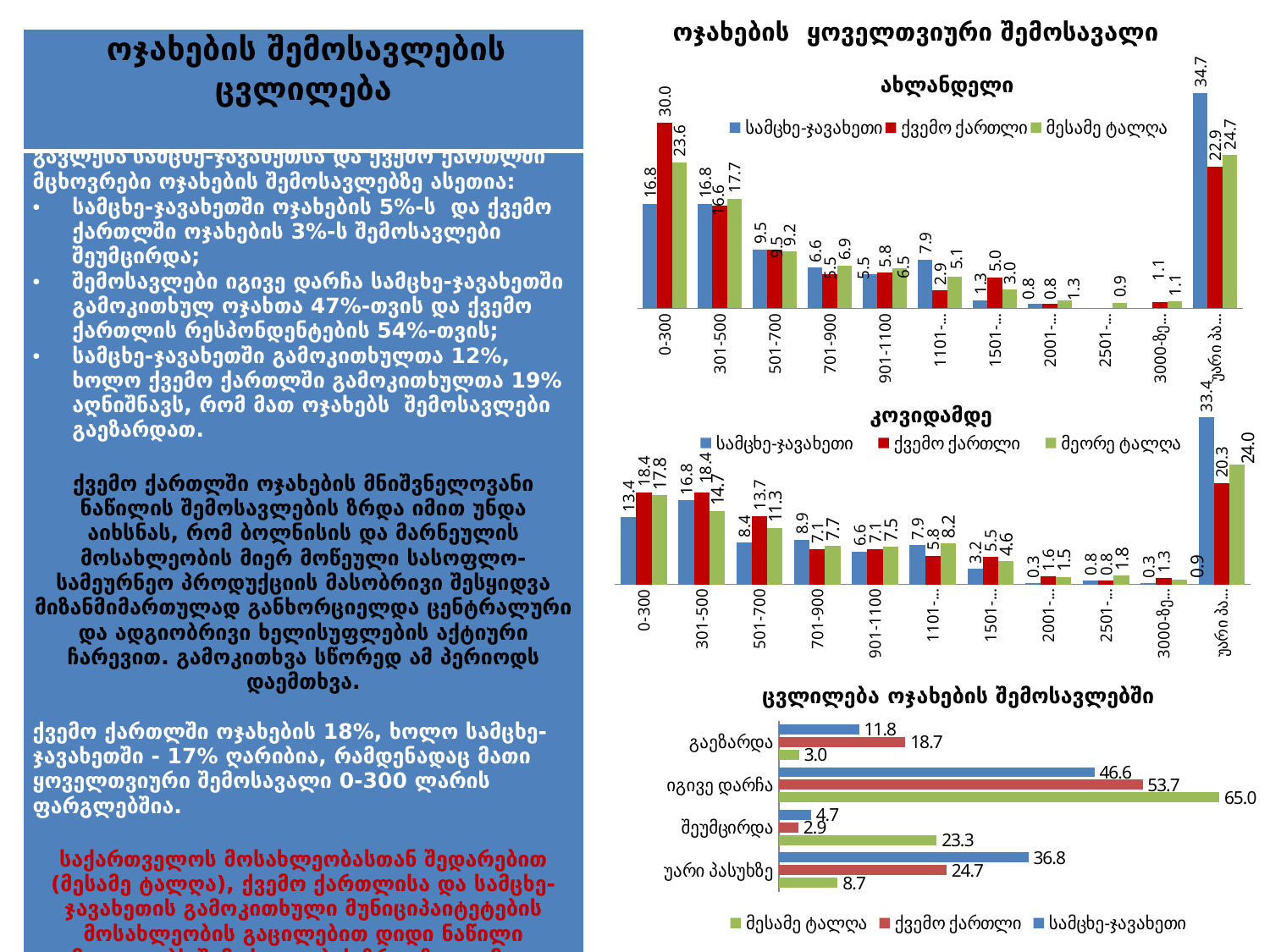
In the bottom chart (ცვლილება ოჯახების შემოსავლებში), what is the value for ქვემო ქართლი in the იგივე დარჩა category? 53.7 What type of chart is the bottom chart (ცვლილება ოჯახების შემოსავლებში)? bar chart In the middle chart (კოვიდამდე), what is the value for სამცხე-ჯავახეთი in the 501-700 category? 8.4 In the middle chart (კოვიდამდე), which is larger in the 0-300 category: ქვემო ქართლი or სამცხე-ჯავახეთი? ქვემო ქართლი In the bottom chart (ცვლილება ოჯახების შემოსავლებში), how many categories are shown? 4 In the middle chart (კოვიდამდე), what is the difference between the ქვემო ქართლი and მეორე ტალღა values in the 501-700 category? 2.4 In the top chart (ახლანდელი), which series has the highest value in the 0-300 category? ქვემო ქართლი In the top chart (ახლანდელი), how many series does the legend list? 3 In the top chart (ახლანდელი), what is the value for ქვემო ქართლი in the 0-300 category? 30.0 In the bottom chart (ცვლილება ოჯახების შემოსავლებში), what is the difference between the ქვემო ქართლი and სამცხე-ჯავახეთი values for უარი პასუხზე? 12.1 In the bottom chart (ცვლილება ოჯახების შემოსავლებში), what is the value for მესამე ტალღა in the შეუმცირდა category? 23.3 In the bottom chart (ცვლილება ოჯახების შემოსავლებში), which category has the highest value for სამცხე-ჯავახეთი? იგივე დარჩა